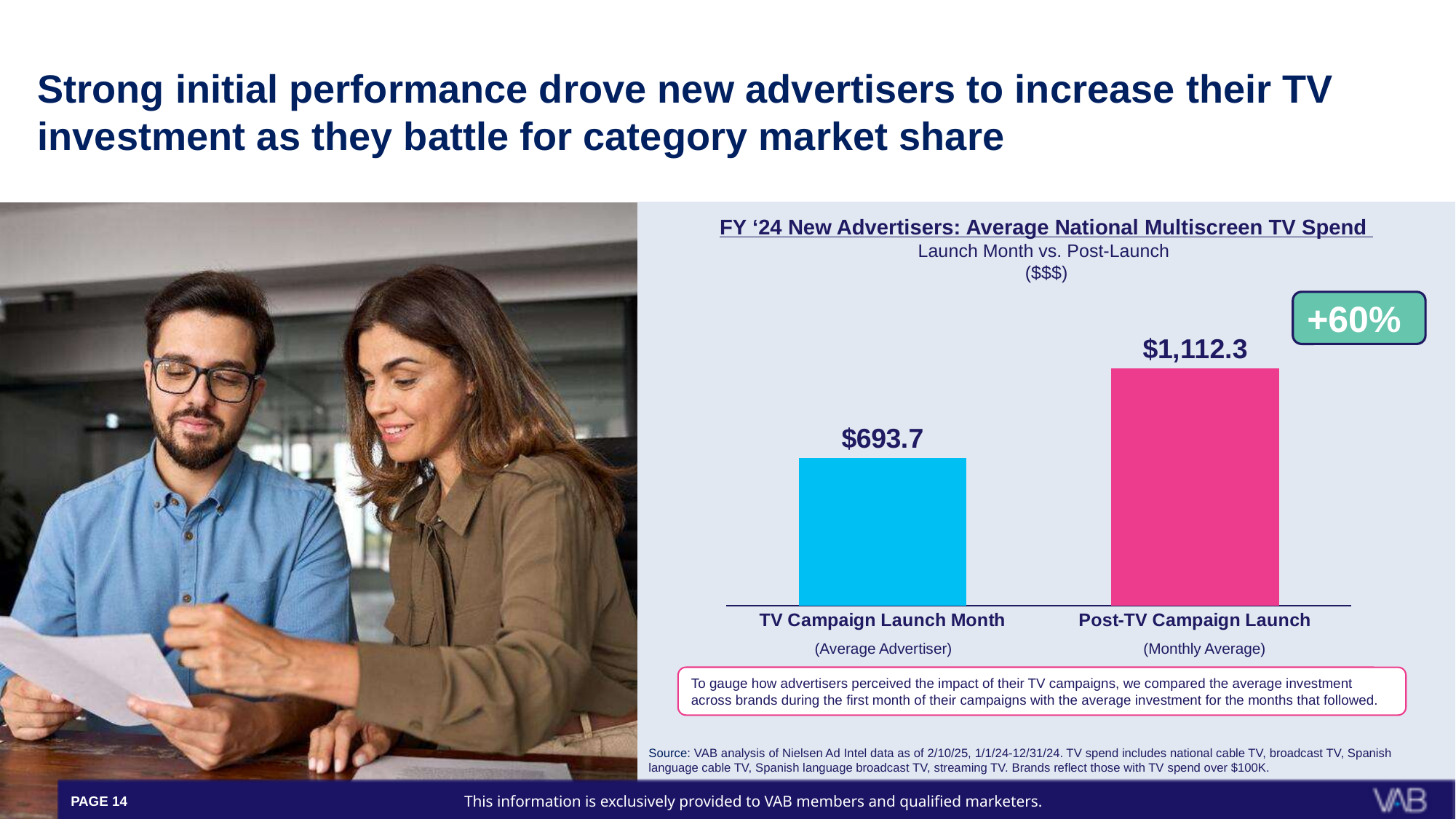
What is the average national multiscreen TV spend for Post-TV Campaign Launch? $1,112.3 What is the title of the chart? FY '24 New Advertisers: Average National Multiscreen TV Spend How many categories are shown in the chart? 2 Is the spend for Post-TV Campaign Launch larger or smaller than the spend for TV Campaign Launch Month? larger What percentage change is shown in the callout box on the chart? +60% What is the difference between the Post-TV Campaign Launch spend and the TV Campaign Launch Month spend? $418.6 Which category has the higher average TV spend? Post-TV Campaign Launch What kind of chart is shown on the slide? bar chart Do the values rise or fall from TV Campaign Launch Month to Post-TV Campaign Launch? rise What is the average national multiscreen TV spend for the TV Campaign Launch Month? $693.7 Which category has the lower average TV spend? TV Campaign Launch Month